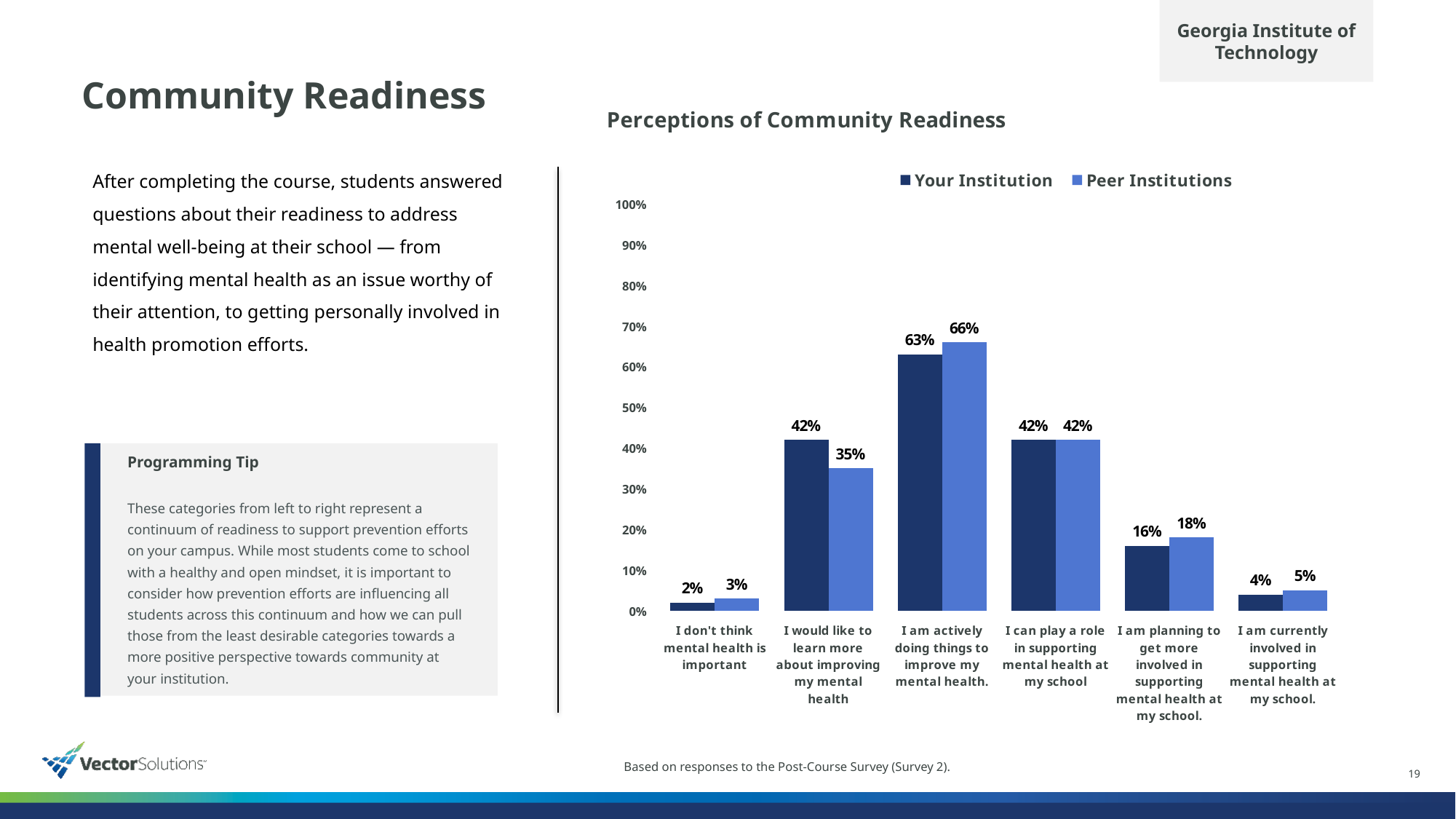
What is the difference between the Peer Institutions and Your Institution values for "I would like to learn more about improving my mental health"? 7% What is the Your Institution value for "I am planning to get more involved in supporting mental health at my school."? 16% For "I am actively doing things to improve my mental health.", which series has the larger value, Your Institution or Peer Institutions? Peer Institutions Is the Your Institution value for "I can play a role in supporting mental health at my school" greater or less than 50%? less What is the Your Institution value for "I am actively doing things to improve my mental health."? 63% What kind of chart is shown on the slide? Bar chart Which category has the highest Your Institution value? I am actively doing things to improve my mental health. How many series does the chart's legend list? 2 Which category has the lowest Peer Institutions value? I don't think mental health is important How many categories are shown on the x axis of the chart? 6 What is the title of the chart? Perceptions of Community Readiness What is the Peer Institutions value for "I would like to learn more about improving my mental health"? 35%